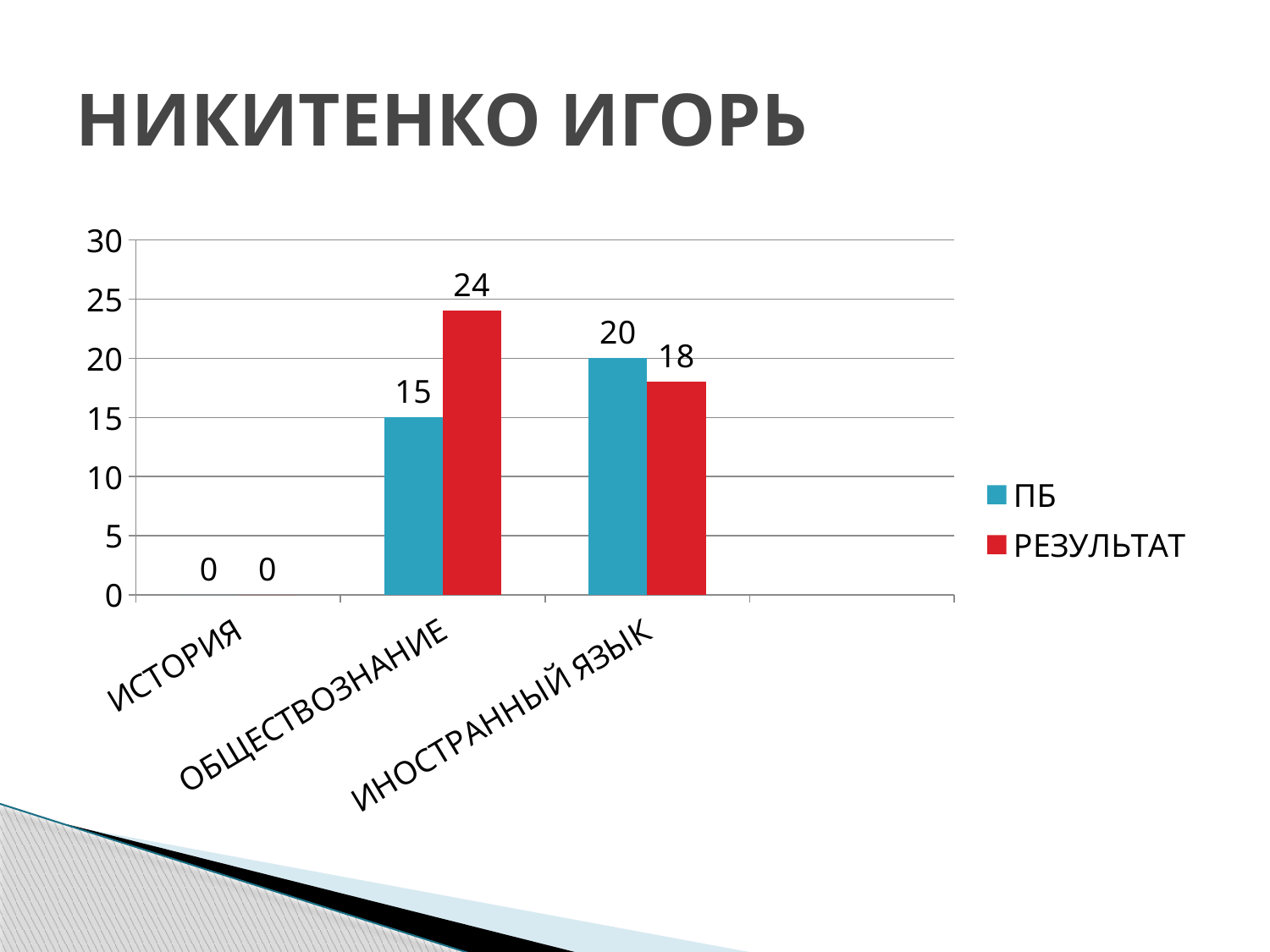
For ИНОСТРАННЫЙ ЯЗЫК, which is larger: ПБ or РЕЗУЛЬТАТ? ПБ What is the РЕЗУЛЬТАТ value for ОБЩЕСТВОЗНАНИЕ? 24 What is the РЕЗУЛЬТАТ value for ИСТОРИЯ? 0 Which category has the lowest ПБ value? ИСТОРИЯ What is the difference between the РЕЗУЛЬТАТ and ПБ values for ОБЩЕСТВОЗНАНИЕ? 9 How many series does the legend list? 2 What is the ПБ value for ИНОСТРАННЫЙ ЯЗЫК? 20 How many categories are shown on the x axis? 3 Which category has the highest РЕЗУЛЬТАТ value? ОБЩЕСТВОЗНАНИЕ What kind of chart is shown on the slide? Bar chart What is the ПБ value for ОБЩЕСТВОЗНАНИЕ? 15 What colour are the РЕЗУЛЬТАТ bars? Red